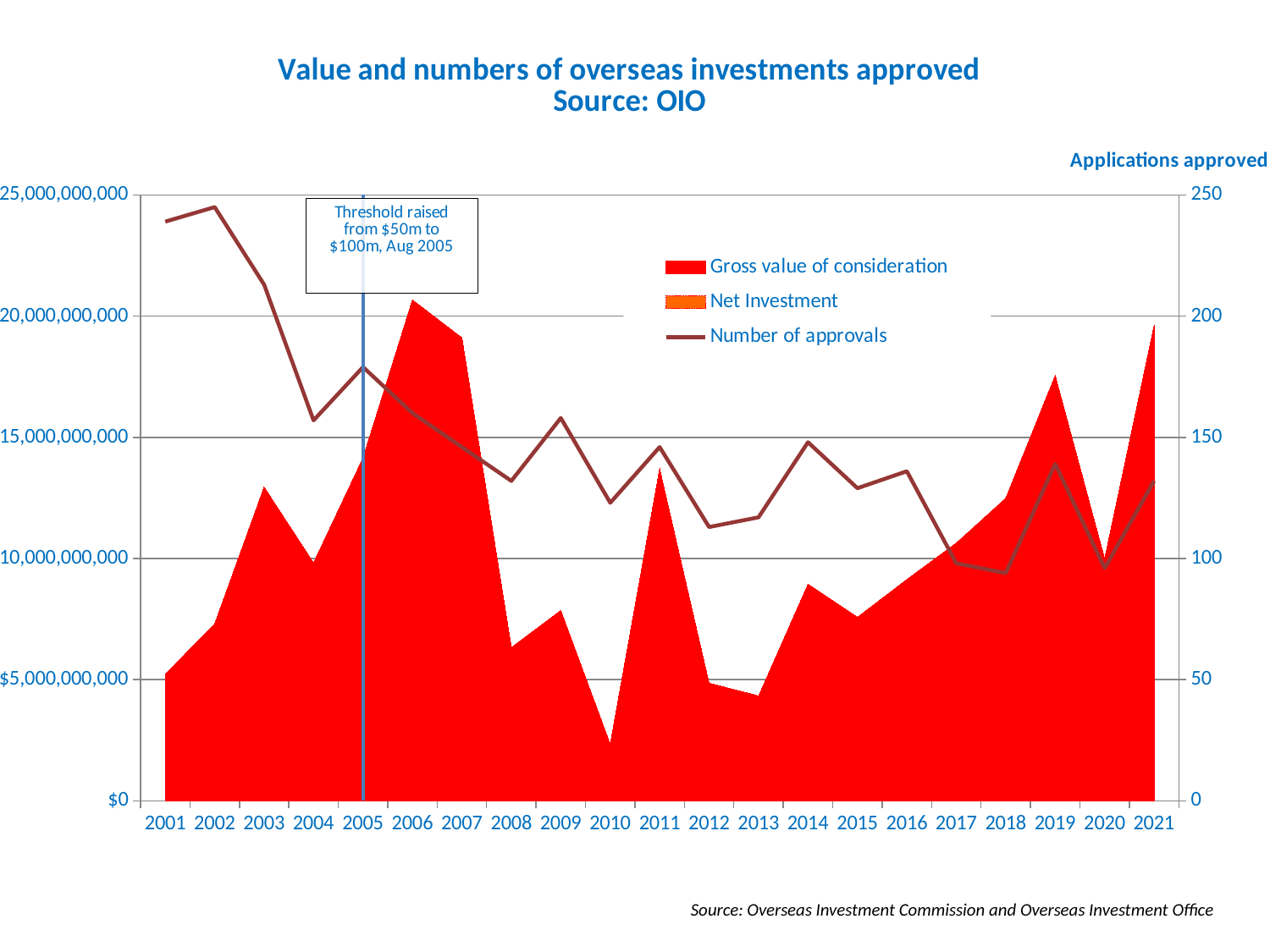
In which year is the number of approvals highest? 2002 Is the gross value of consideration for 2010 greater or less than $5,000,000,000? less How many series does the legend list? 3 Is the gross value of consideration for 2021 greater or less than $15,000,000,000? greater In which year is the gross value of consideration highest? 2006 In which year is the gross value of consideration lowest? 2010 Is the number of approvals for 2001 greater or less than 200? greater What does the annotation box on the chart say? Threshold raised from $50m to $100m, Aug 2005 Which year has the larger gross value of consideration, 2019 or 2020? 2019 What kind of chart is shown on the slide? A combination area and line chart How many years are shown along the x axis? 21 Does the number of approvals rise or fall from 2001 to 2004? fall